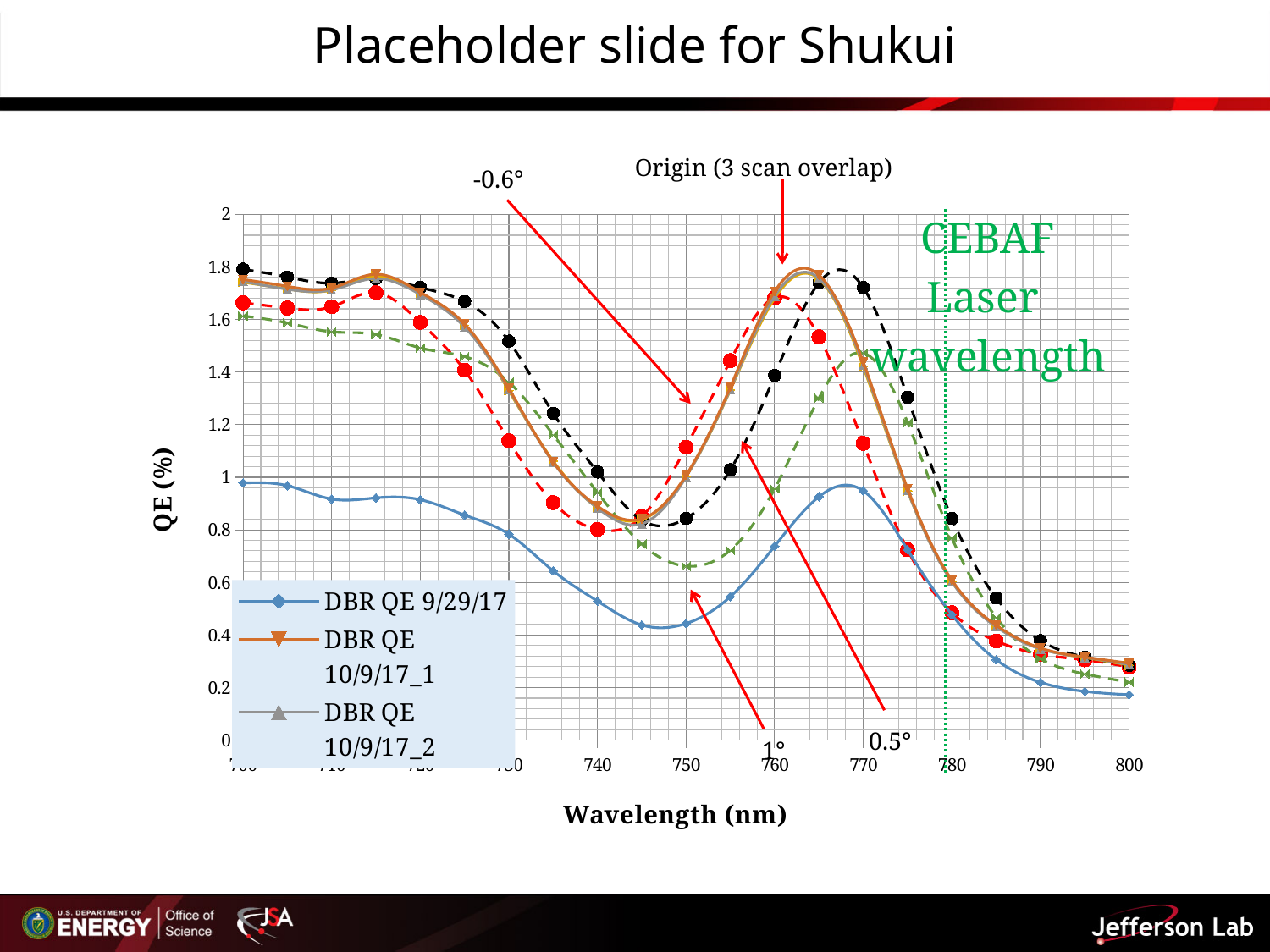
Is the value of DBR QE 10/9/17_1 at 800 nm greater or less than 0.4? less What is the y-axis title of the chart? QE (%) What kind of chart is shown on the slide? line chart Is the value of DBR QE 10/9/17_1 at 700 nm greater or less than 1.6? greater At 700 nm, which series has the larger value: DBR QE 9/29/17 or DBR QE 10/9/17_1? DBR QE 10/9/17_1 Is the value of DBR QE 9/29/17 at 700 nm greater or less than 0.8? greater Which of the legend series has the lowest QE values across the wavelength range? DBR QE 9/29/17 Does the DBR QE 9/29/17 series rise or fall between 780 nm and 800 nm? fall What is the x-axis title of the chart? Wavelength (nm) How many series does the visible legend list? 3